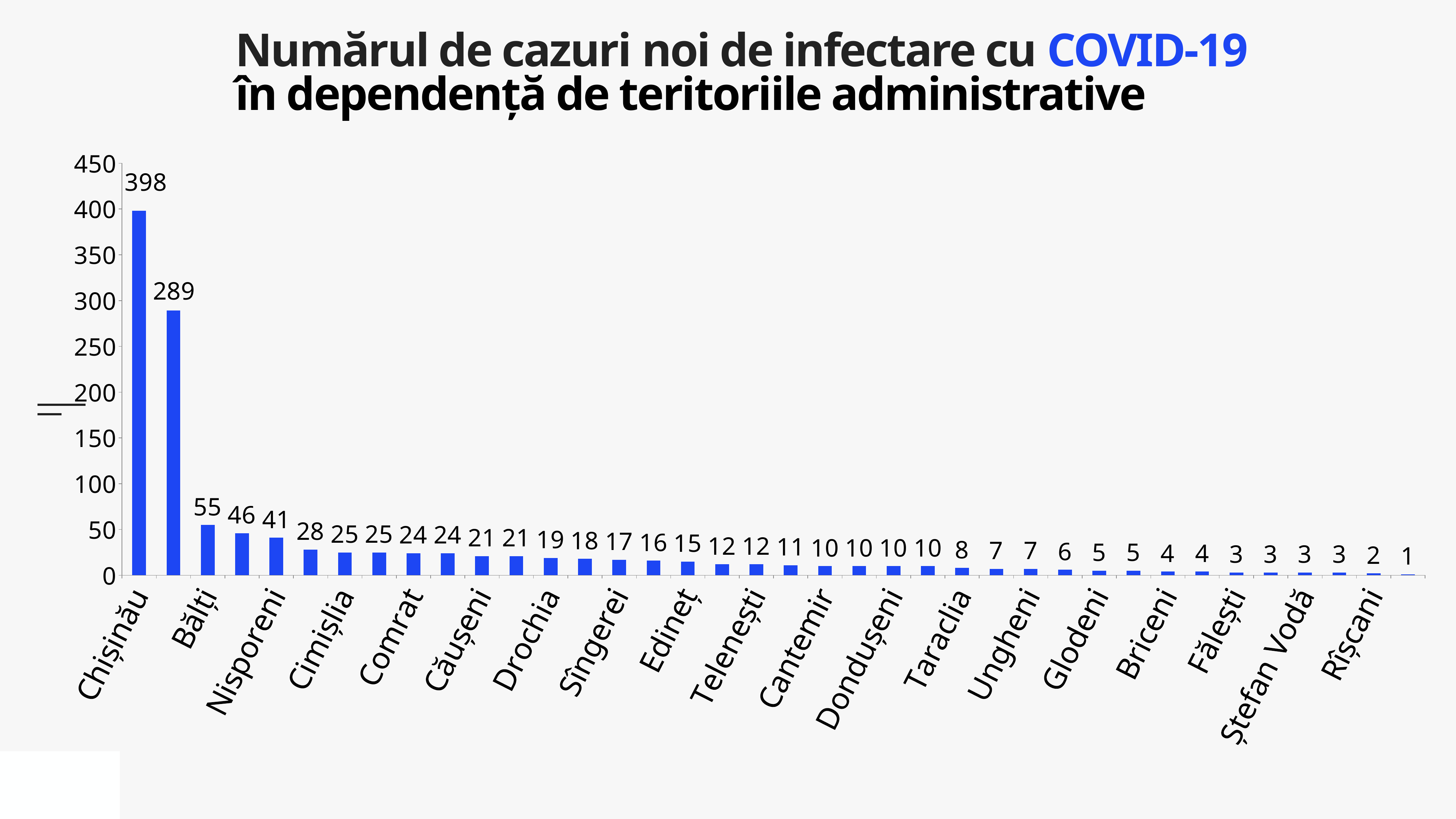
What is the value of the smallest bar in the chart? 1 What is the value of the tallest bar, for Chișinău? 398 How many category labels are printed along the x axis? 19 Is the value for Chișinău greater or less than 350? greater Which administrative territory has the highest number of new COVID-19 cases? Chișinău What is the highest tick value shown on the vertical axis? 450 What kind of chart is shown on the slide? bar chart What is the difference between the two tallest bars (398 and 289)? 109 Do the bar values rise or fall from left to right along the x axis? fall Is the value of the second-tallest bar greater or less than 300? less What is the value of the second-tallest bar in the chart? 289 What colour are the bars in the chart? blue